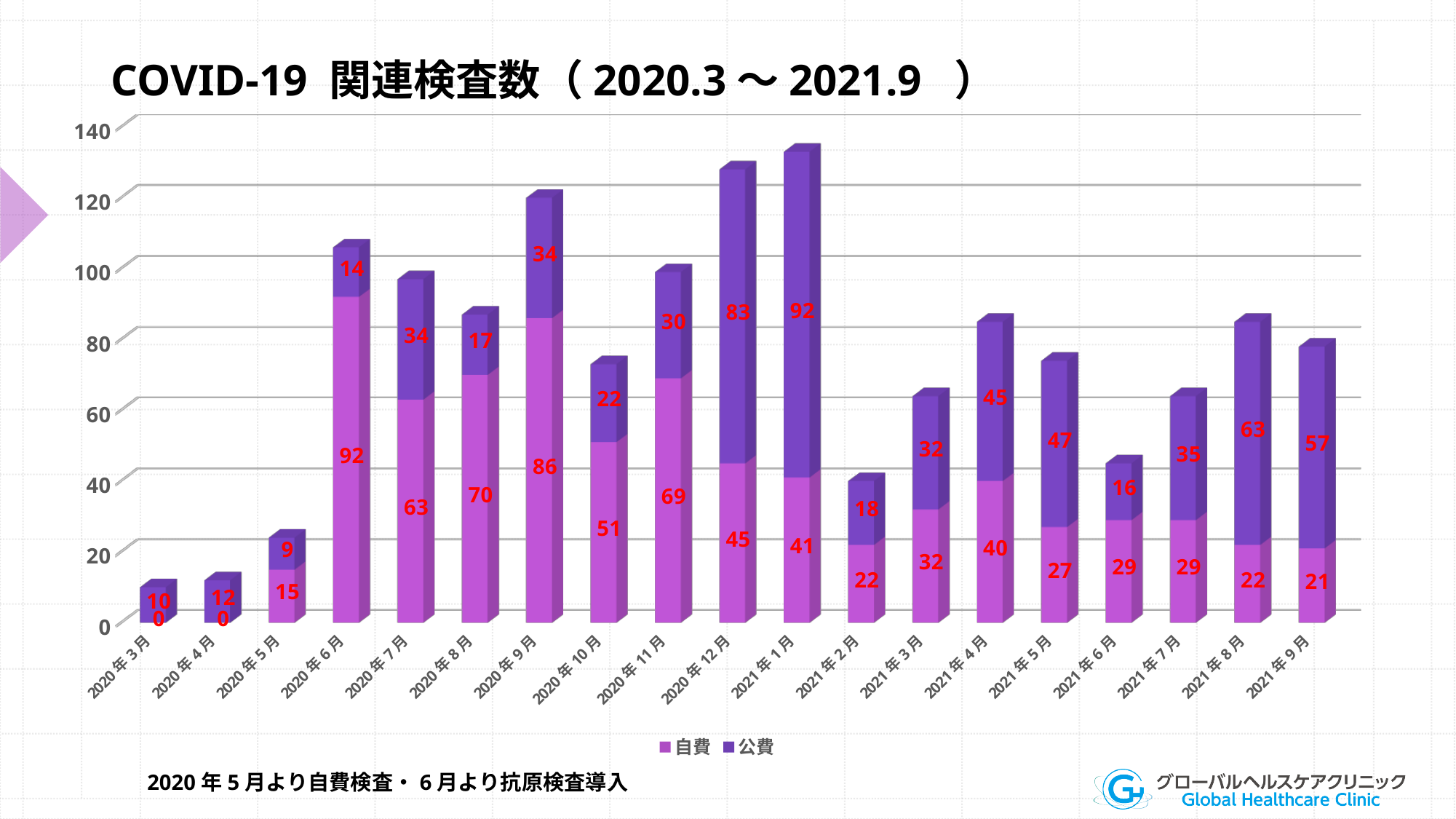
What kind of chart is shown on the slide? Stacked bar chart Which month has the highest 公費 value? 2021年1月 Which is larger, the 自費 value for 2020年7月 or for 2020年8月? 2020年8月 What is the 自費 value for 2020年10月? 51 How many series does the legend list? 2 What is the difference between the 公費 values for 2021年8月 and 2021年9月? 6 How many months are shown on the x axis? 19 What is the total of the stacked bar for 2021年1月? 133 What is the total of the stacked bar for 2020年12月? 128 What is the 公費 value for 2021年1月? 92 What is the 自費 value for 2020年6月? 92 Which month has the lowest 公費 value? 2020年5月